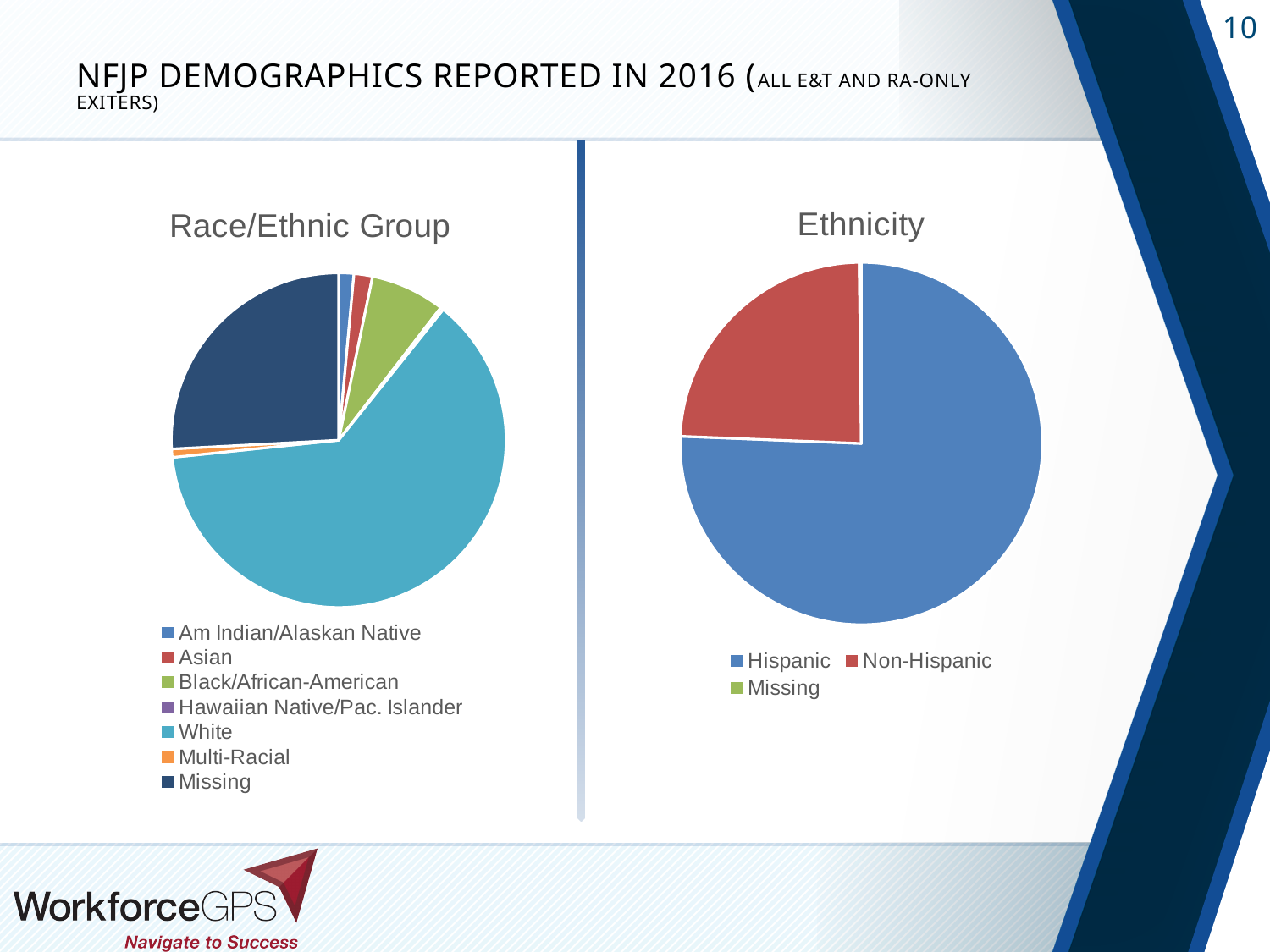
How many categories does the legend of the Ethnicity chart list? 3 How many pie charts are shown on the slide? 2 How many categories does the legend of the Race/Ethnic Group chart list? 7 In the Ethnicity chart, what colour is the Non-Hispanic slice? Red In the Race/Ethnic Group chart, which category has the largest slice? White What kind of chart is the Race/Ethnic Group chart? Pie chart What kind of chart is the Ethnicity chart? Pie chart In the Race/Ethnic Group chart, which is larger, Missing or Black/African-American? Missing In the Race/Ethnic Group chart, which is larger, White or Missing? White In the Ethnicity chart, which category has the largest slice? Hispanic In the Ethnicity chart, which is larger, Hispanic or Non-Hispanic? Hispanic